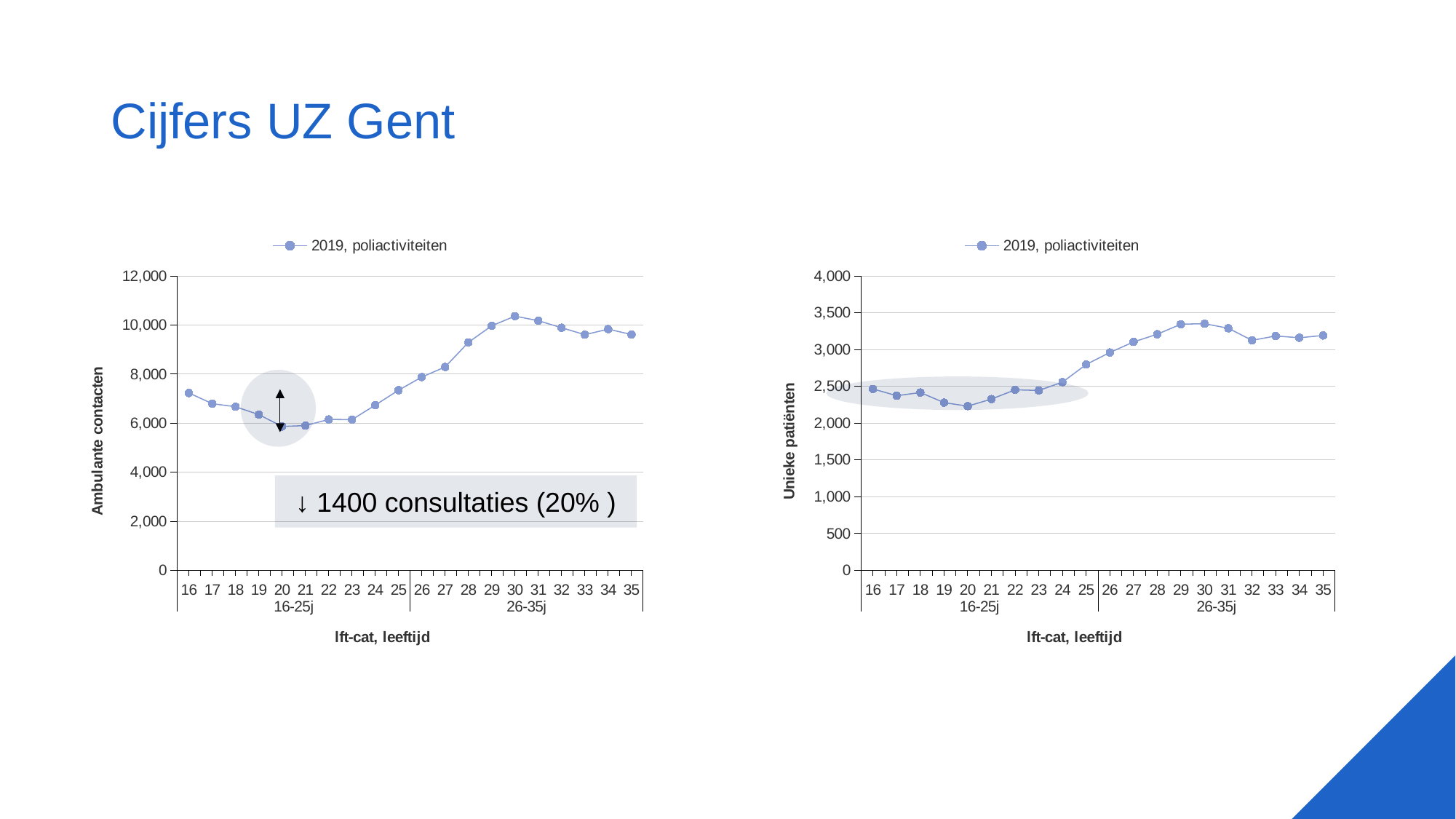
In the left chart (Ambulante contacten), which is larger, the value for age 16 or the value for age 35? 35 What kind of chart is the left chart (Ambulante contacten)? line chart How many series does the legend of the right chart (Unieke patiënten) list? 1 In the left chart (Ambulante contacten), is the value for age 30 greater or less than 10,000? greater In the left chart (Ambulante contacten), is the value for age 16 greater or less than 6,000? greater How many age categories are plotted along the x axis of the left chart (Ambulante contacten)? 20 In the right chart (Unieke patiënten), which is larger, the value for age 16 or the value for age 35? 35 In the right chart (Unieke patiënten), do the values rise or fall from age 23 to age 29? rise What is the y-axis title of the right chart? Unieke patiënten In the left chart (Ambulante contacten), which age has the highest value? 30 In the right chart (Unieke patiënten), is the value for age 30 greater or less than 3,000? greater